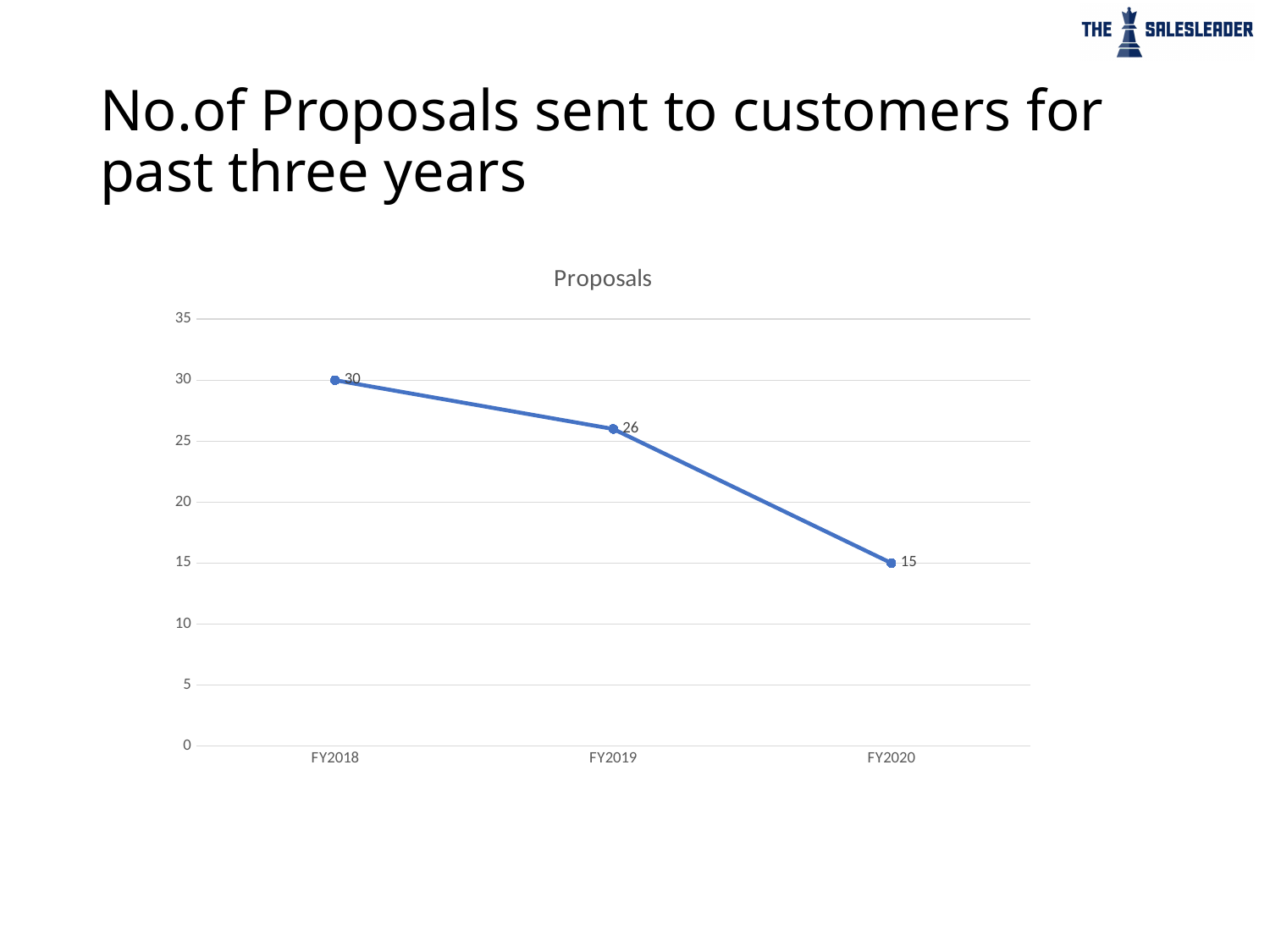
What is the value for FY2018? 30 Which year has the lowest number of proposals? FY2020 What is the value for FY2019? 26 What kind of chart is shown on the slide? line chart What is the difference between the values for FY2018 and FY2020? 15 How many years are plotted on the chart? 3 Which year has the highest number of proposals? FY2018 What is the difference between the values for FY2019 and FY2020? 11 What is the value for FY2020? 15 Which is larger, the value for FY2019 or the value for FY2020? FY2019 Is the value for FY2019 greater or less than 20? greater Do the values rise or fall from FY2018 to FY2020? fall